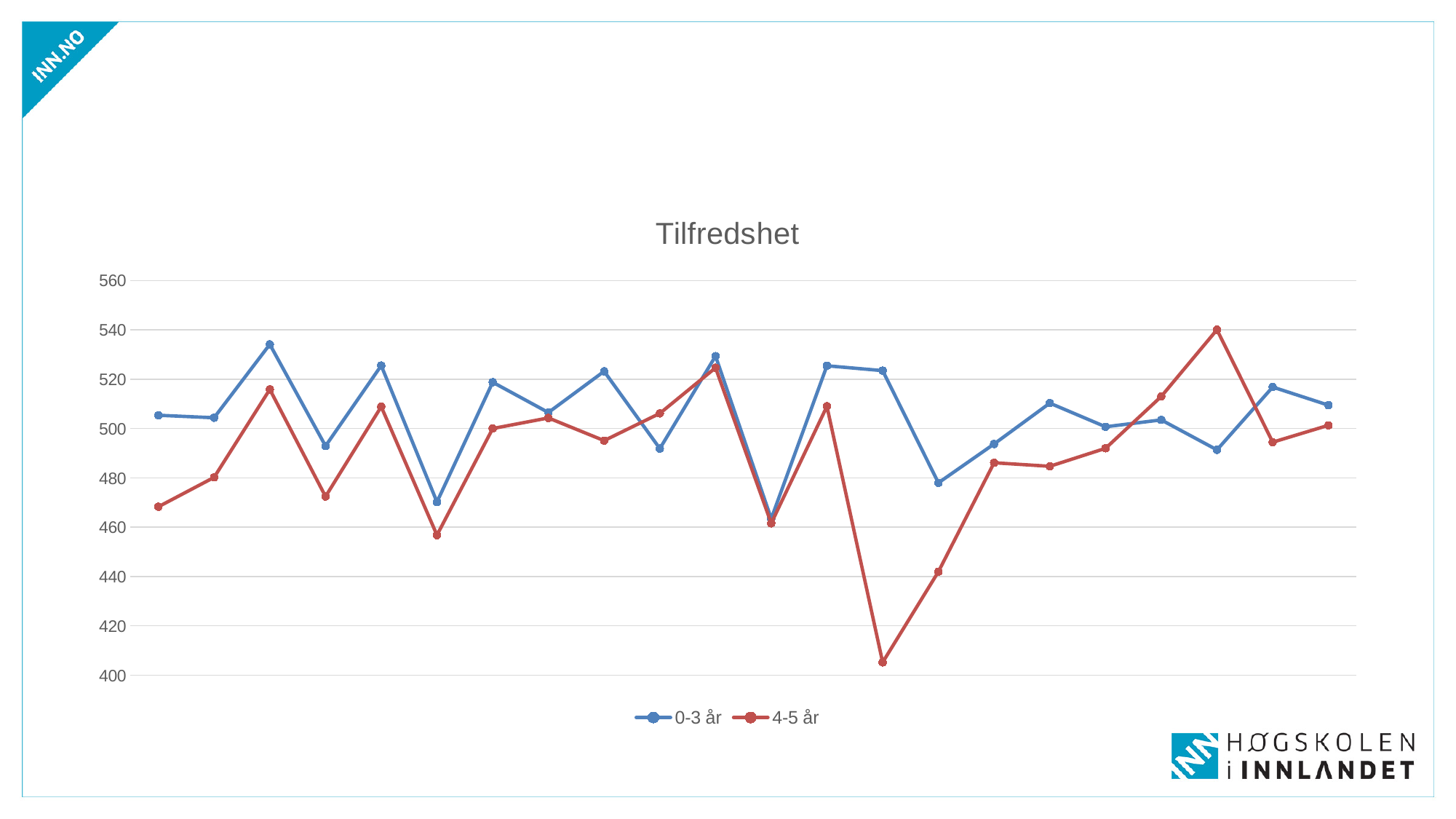
What kind of chart is shown on the slide? line chart Which series reaches the lowest value anywhere on the chart? 4-5 år Is the highest point of the 4-5 år series greater or less than 520? greater Is the lowest point of the 4-5 år series greater or less than 420? less At the first data point, which series has the higher value? 0-3 år How many series does the legend list? 2 Is the first point of the 0-3 år series greater or less than 500? greater What is the title of the chart? Tilfredshet What colour is the line for the 4-5 år series? red How many data points does each series have? 22